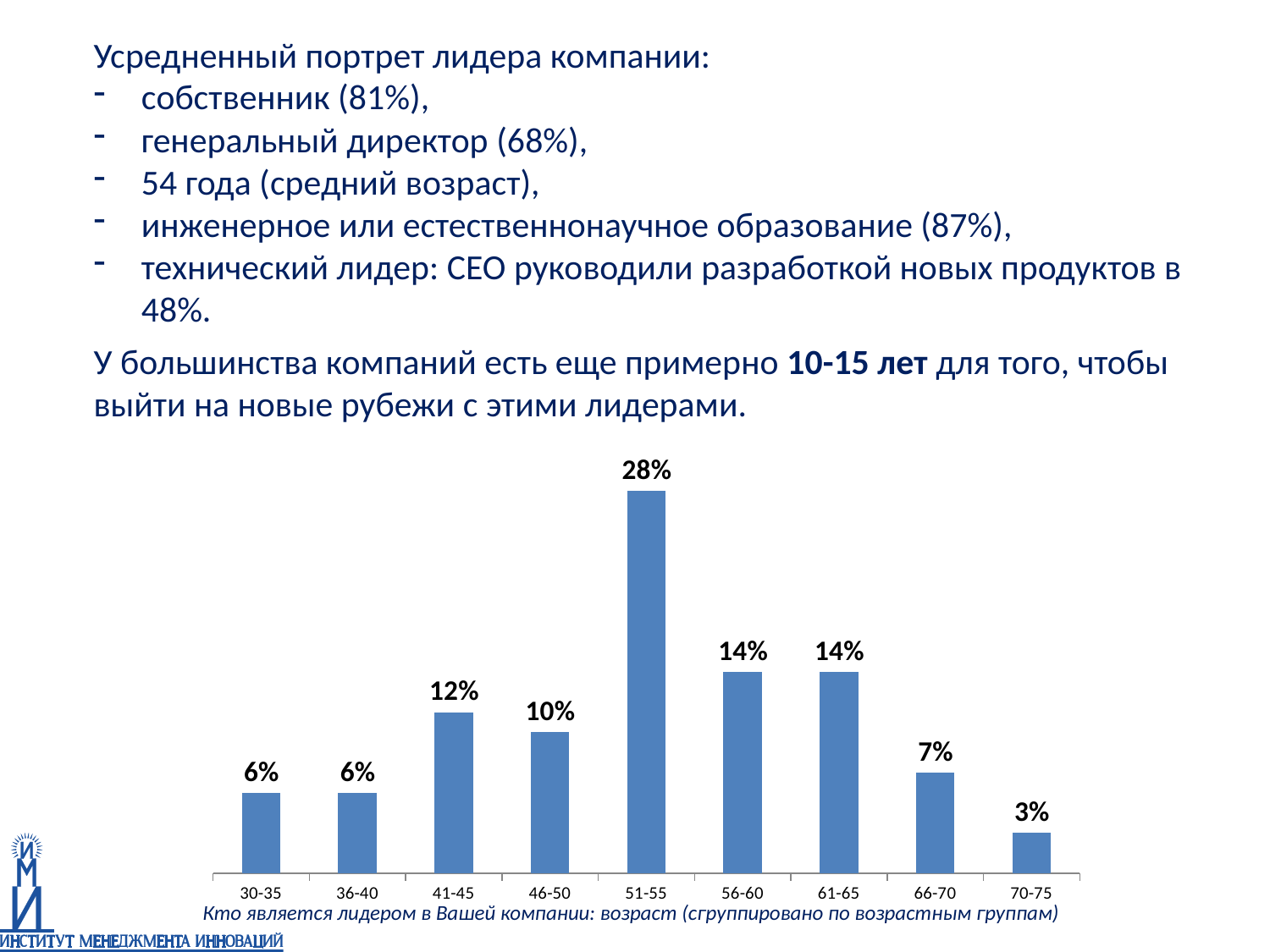
Which is larger, the value for 41-45 or the value for 46-50? 41-45 What is the value for the 51-55 age group? 28% Do the values rise or fall from the 51-55 group to the 70-75 group? fall What is the difference between the values for 51-55 and 56-60? 14% What kind of chart is shown on the slide? bar chart Which age group has the highest value? 51-55 What is the value for the 41-45 age group? 12% Which age group has the lowest value? 70-75 What is the difference between the values for 46-50 and 66-70? 3% What is the caption printed below the chart? Кто является лидером в Вашей компании: возраст (сгруппировано по возрастным группам) What is the value for the 70-75 age group? 3% How many age groups are shown on the x axis? 9